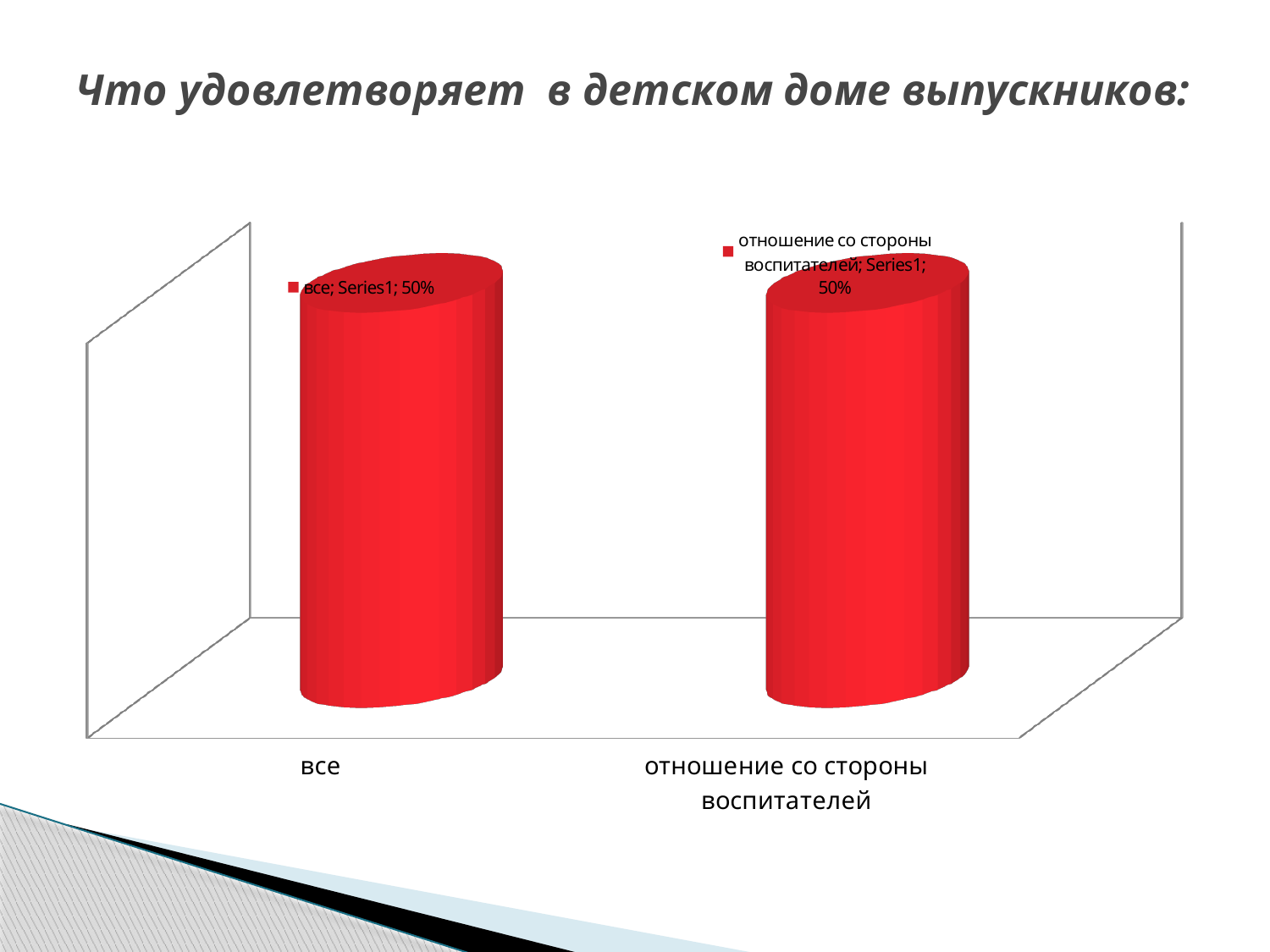
What is the value for the category "все"? 50% What is the title of the slide? Что удовлетворяет в детском доме выпускников: What is the sum of the two values shown on the chart? 100% How many categories are shown on the chart? 2 What colour are the bars on the chart? Red What is the difference between the values for "все" and "отношение со стороны воспитателей"? 0% What series name appears in the data labels on the chart? Series1 What kind of chart is shown on the slide? Bar chart Is the value for "все" larger than, smaller than, or equal to the value for "отношение со стороны воспитателей"? Equal What is the value for the category "отношение со стороны воспитателей"? 50%